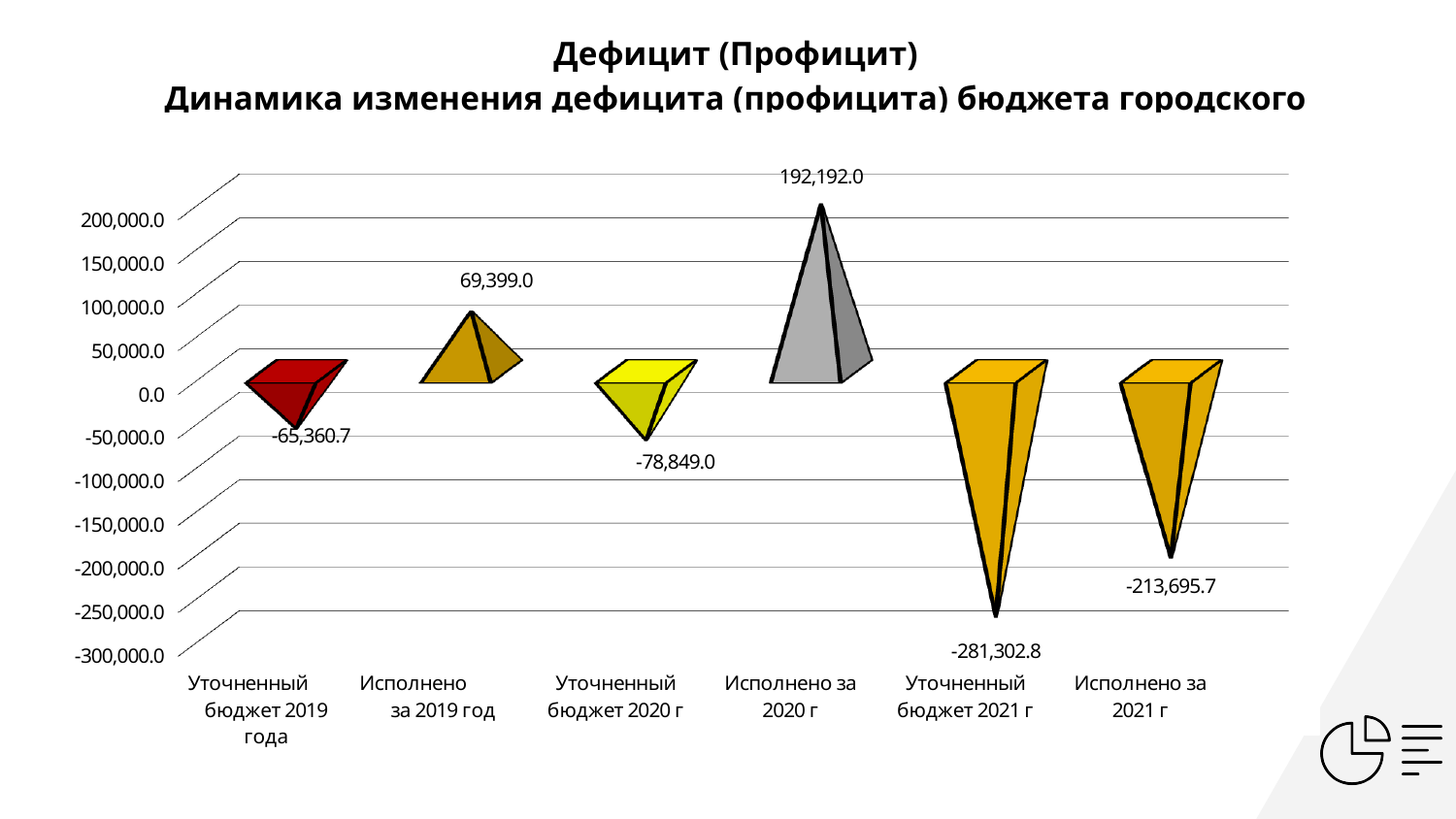
Which category has the lowest value? Уточненный бюджет 2021 г Is the value for Исполнено за 2021 г greater or less than -200,000.0? less Which category has the highest value? Исполнено за 2020 г What is the value for Исполнено за 2020 г? 192,192.0 How many categories are shown on the x axis? 6 What is the difference between the values for Уточненный бюджет 2021 г and Исполнено за 2021 г? 67,607.1 What is the value for Уточненный бюджет 2019 года? -65,360.7 What is the value for Исполнено за 2019 год? 69,399.0 What is the difference between the values for Исполнено за 2020 г and Исполнено за 2019 год? 122,793.0 Which is larger, the value for Уточненный бюджет 2019 года or the value for Уточненный бюджет 2020 г? Уточненный бюджет 2019 года What kind of chart is shown on the slide? Bar chart What is the value for Уточненный бюджет 2021 г? -281,302.8